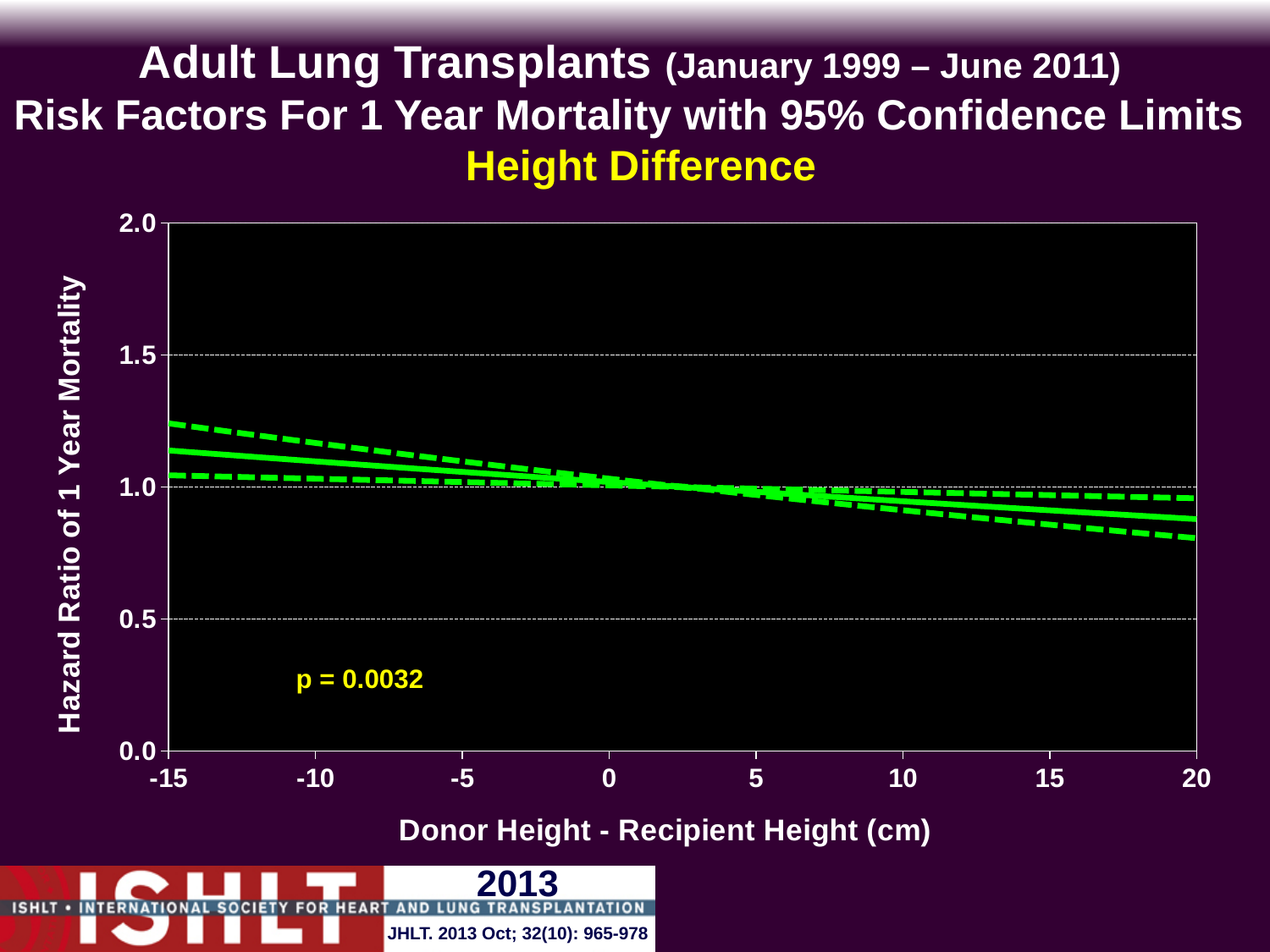
How many lines are plotted on the chart? 3 Which has the larger hazard ratio on the solid line: a height difference of -15 cm or 20 cm? -15 cm Is the upper 95% confidence limit at a height difference of -15 cm greater or less than 1.5? less What is the lowest value shown on the x axis? -15 What is the label of the x axis? Donor Height - Recipient Height (cm) What is the highest value shown on the y axis? 2.0 Is the hazard ratio (solid line) at a height difference of -15 cm greater or less than 1.0? greater What kind of chart is shown on the slide? Line chart Does the hazard ratio of 1 year mortality rise or fall as the donor height minus recipient height increases from -15 to 20 cm? Fall Is the lower 95% confidence limit at a height difference of 20 cm greater or less than 1.0? less What p-value is printed on the chart? p = 0.0032